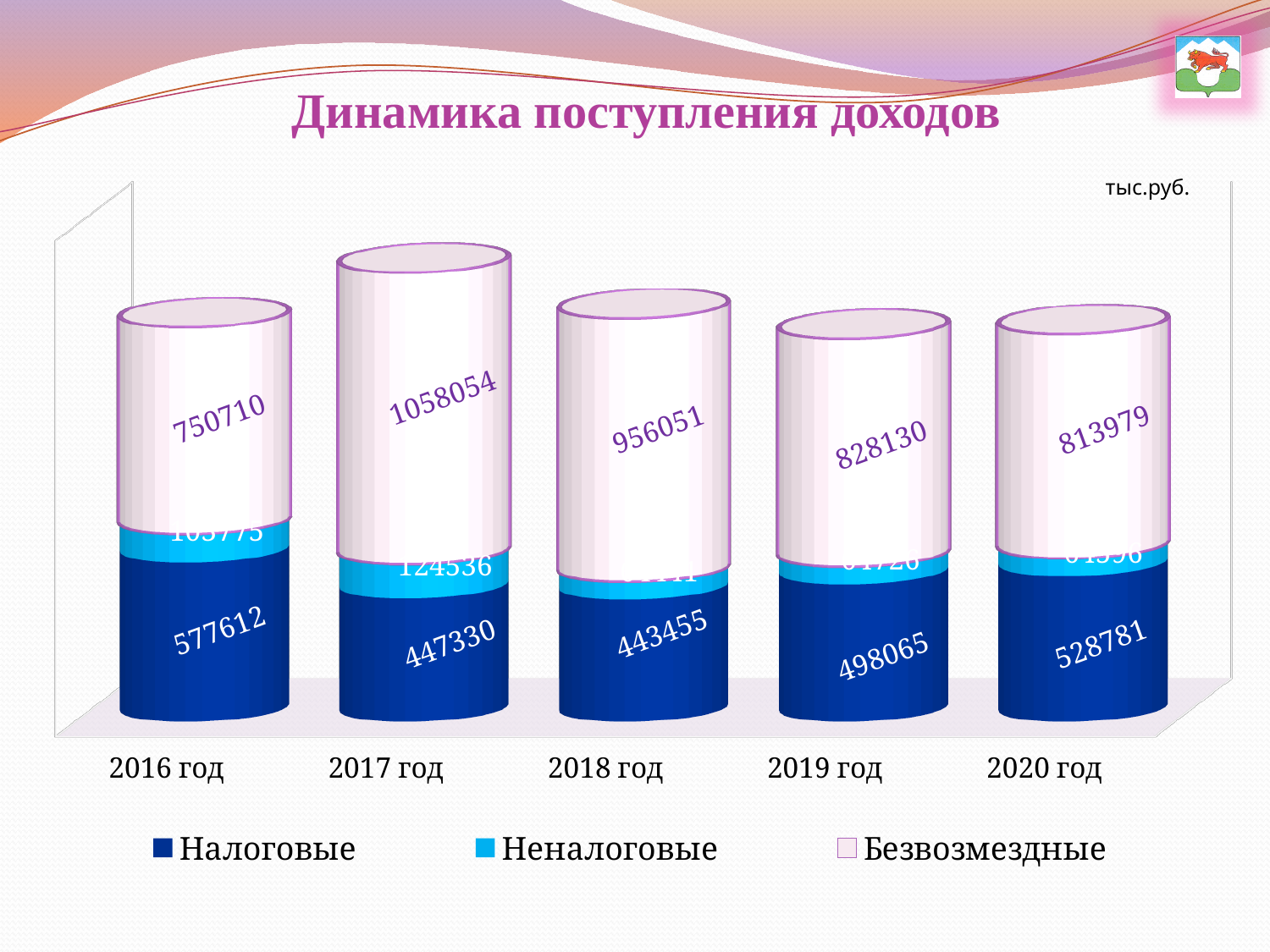
Which year has the larger Безвозмездные value, 2019 год or 2020 год? 2019 год How many series does the legend list? 3 How many years are shown on the x axis? 5 What is the difference between the Безвозмездные values for 2017 год and 2018 год? 102003 In which year is the Налоговые value the lowest? 2018 год What is the difference between the Налоговые values for 2020 год and 2019 год? 30716 What is the value of Неналоговые for 2017 год? 124536 What is the value of Налоговые for 2016 год? 577612 What is the value of Безвозмездные for 2017 год? 1058054 In which year is the Безвозмездные value the highest? 2017 год What kind of chart is shown on the slide? Stacked bar chart What unit is indicated in the top right corner of the chart? тыс.руб.